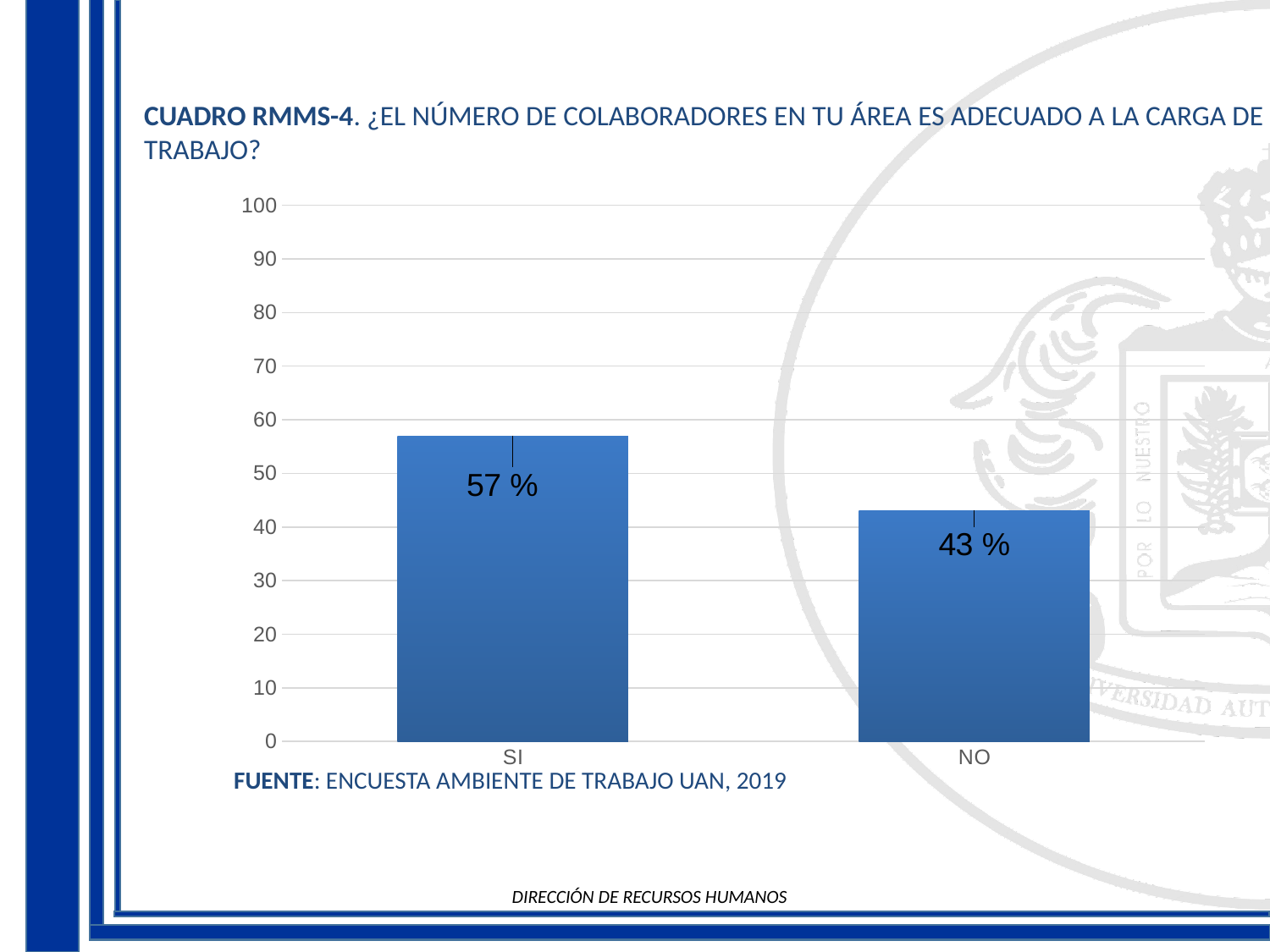
Is the value for SI greater or less than 50? greater What kind of chart is shown on the slide? bar chart Which category has the lowest value? NO How many categories are shown on the x axis? 2 Is the value for NO greater or less than 50? less Which is larger, the value for SI or the value for NO? SI What source is cited below the chart? ENCUESTA AMBIENTE DE TRABAJO UAN, 2019 What is the value for SI? 57 % What is the maximum value shown on the y axis? 100 What is the difference between the values for SI and NO? 14 % Which category has the highest value? SI What is the value for NO? 43 %